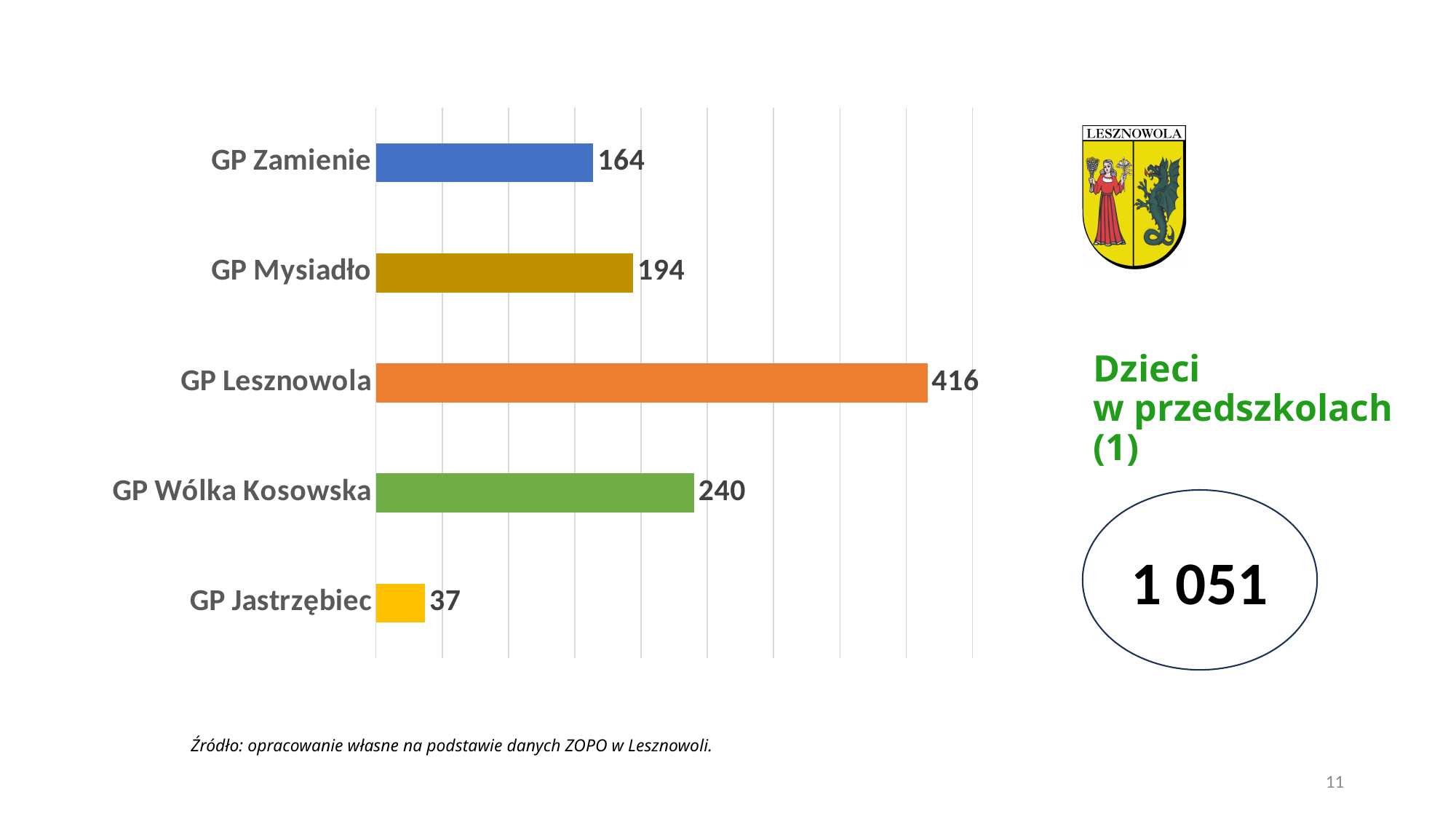
What is the value for GP Jastrzębiec? 37 What is the value for GP Zamienie? 164 What is the value for GP Wólka Kosowska? 240 What colour is the bar for GP Lesznowola? Orange Which category has the highest value? GP Lesznowola What is the difference between the values for GP Lesznowola and GP Wólka Kosowska? 176 Which category has the lowest value? GP Jastrzębiec What is the value for GP Lesznowola? 416 What is the value for GP Mysiadło? 194 What kind of chart is shown on the slide? Bar chart How many categories are shown in the chart? 5 Which is larger, the value for GP Mysiadło or the value for GP Zamienie? GP Mysiadło